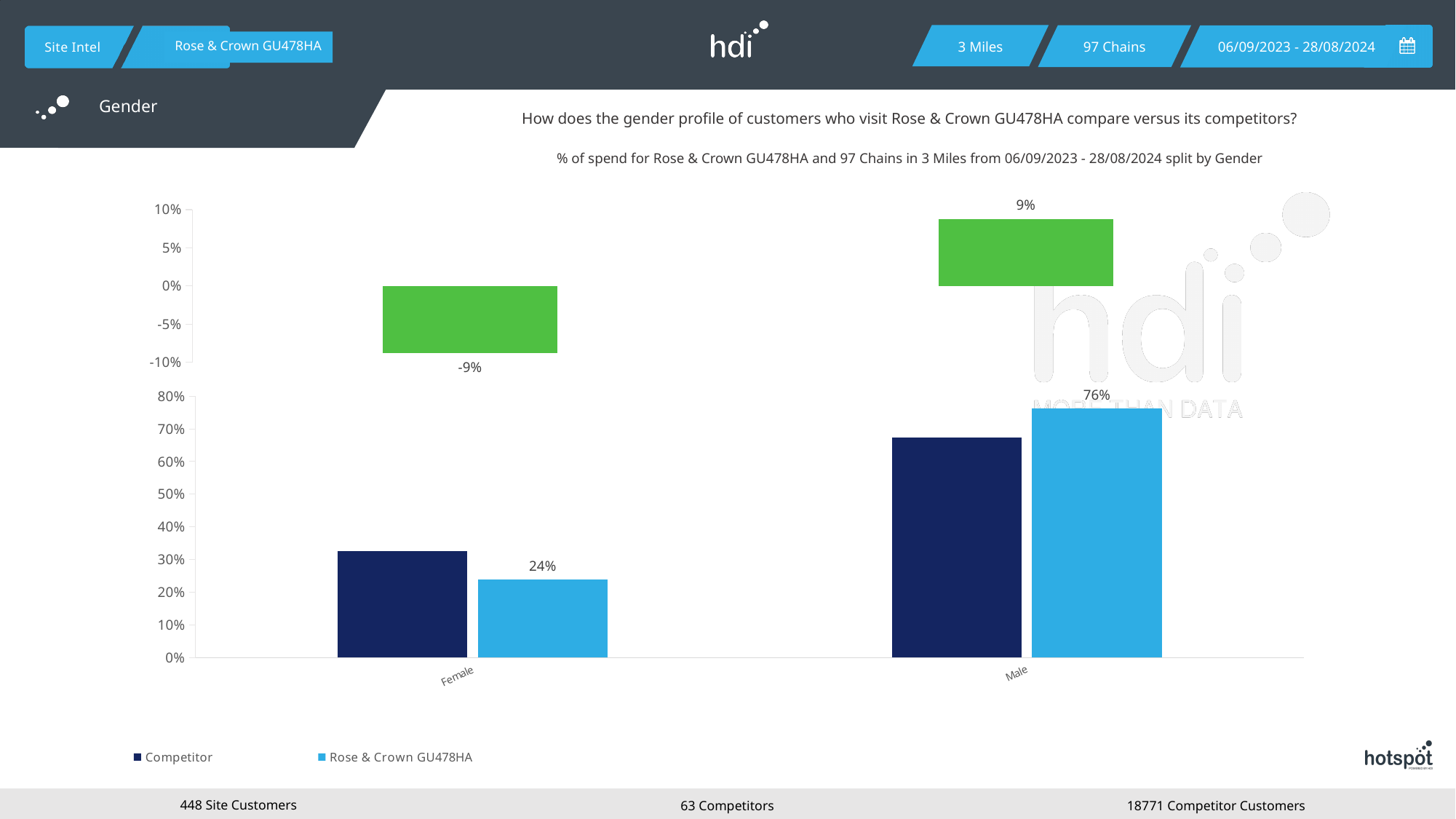
What type of chart is the bottom chart? Bar chart In the bottom chart, is the Competitor value for Female greater or less than 40%? less How many series does the legend list? 2 In the top chart, what is the value shown for Male? 9% In the bottom chart, which category has the highest value for Rose & Crown GU478HA? Male In the bottom chart, for Female, which is larger: the Competitor value or the Rose & Crown GU478HA value? Competitor In the bottom chart, what is the difference between the Rose & Crown GU478HA values for Male and Female? 52% In the bottom chart, is the Competitor value for Male greater or less than 60%? greater In the bottom chart, what is the value for Rose & Crown GU478HA for Female? 24% How many categories are shown on the x axis of the bottom chart? 2 In the bottom chart, what is the value for Rose & Crown GU478HA for Male? 76% In the top chart, what is the value shown for Female? -9%